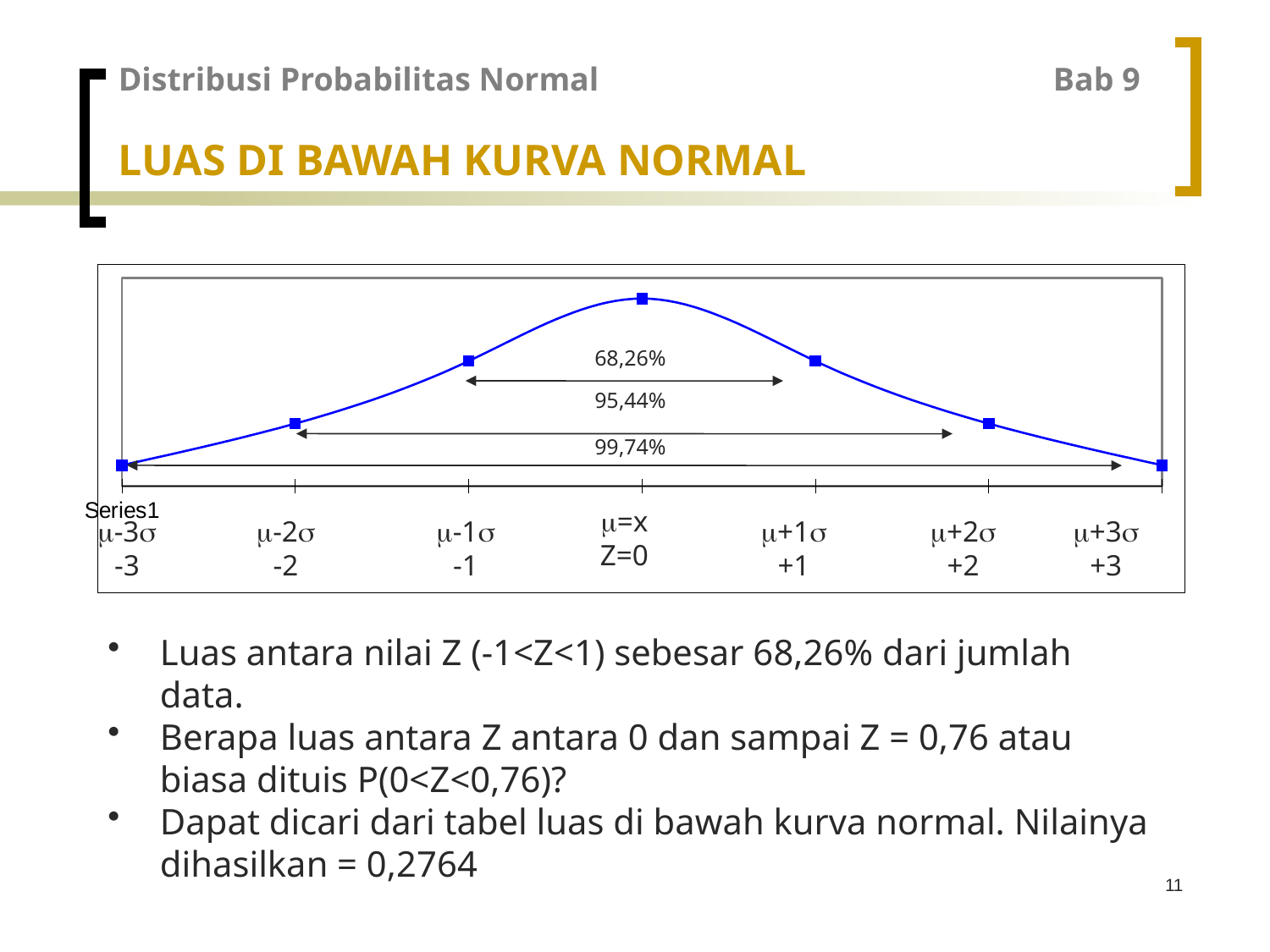
What colour is the plotted curve? blue How many series does the legend list? 1 What is the name of the series shown in the legend? Series1 What is the difference between the 95,44% and 68,26% areas shown on the chart? 27,18% What percentage is labelled for the area between Z = -1 and Z = +1? 68,26% At which Z value does the curve reach its highest point? Z=0 What percentage is labelled for the area between Z = -3 and Z = +3? 99,74% What percentage is labelled for the area between Z = -2 and Z = +2? 95,44% How many data points are plotted on the curve? 7 Does the curve rise or fall as Z goes from -3 to 0? rise Which point on the curve is higher, the one at +1 or the one at +2? +1 What kind of chart is shown on the slide? line chart